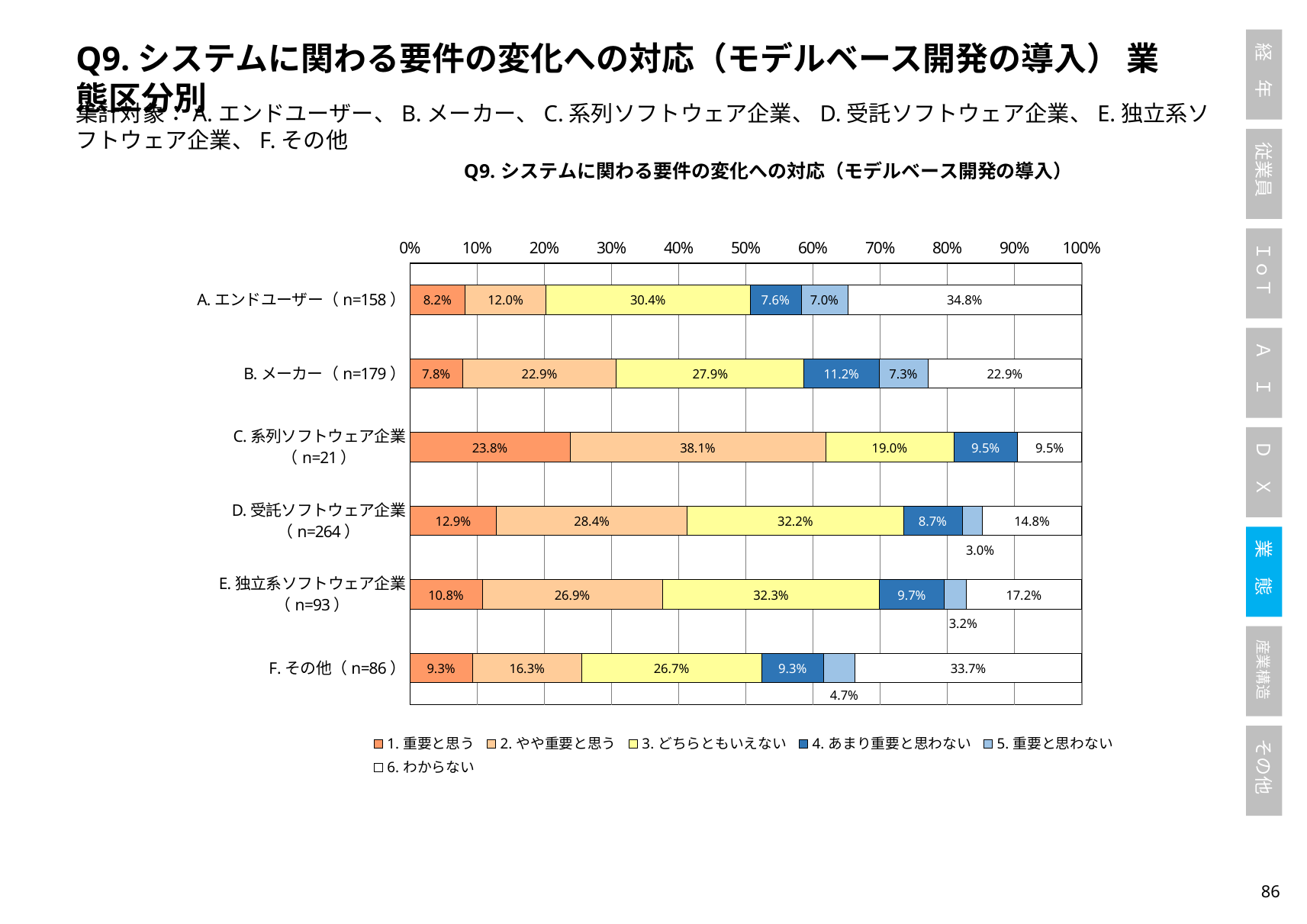
How many series does the legend list? 6 Which category has the lowest value for "6. わからない"? C. 系列ソフトウェア企業 (n=21) Which category has the highest value for "1. 重要と思う"? C. 系列ソフトウェア企業 (n=21) What is the value of "1. 重要と思う" for C. 系列ソフトウェア企業 (n=21)? 23.8% How many categories (respondent groups) are plotted on the chart? 6 Which is larger: the "4. あまり重要と思わない" value for B. メーカー (n=179) or for D. 受託ソフトウェア企業 (n=264)? B. メーカー (n=179) What is the sample size (n) shown for D. 受託ソフトウェア企業? 264 What kind of chart is shown on the slide? Stacked bar chart What is the difference between the "2. やや重要と思う" values for B. メーカー (n=179) and A. エンドユーザー (n=158)? 10.9% What is the value of "5. 重要と思わない" for F. その他 (n=86)? 4.7% What is the value of "6. わからない" for A. エンドユーザー (n=158)? 34.8% What is the value of "3. どちらともいえない" for E. 独立系ソフトウェア企業 (n=93)? 32.3%